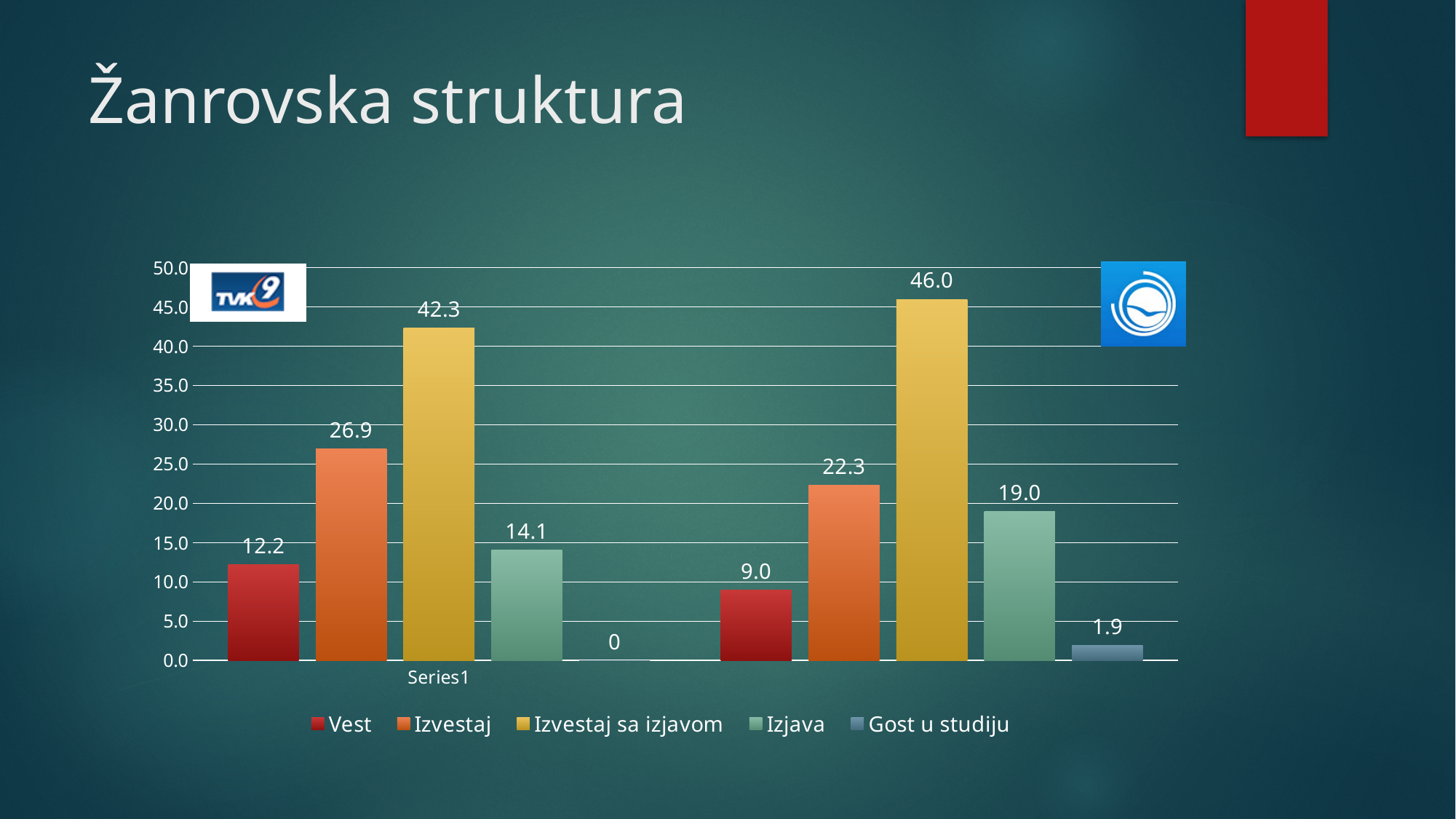
How many series does the legend list? 5 Which series has the lowest value in the left group of bars? Gost u studiju What is the value of the Gost u studiju bar in the right group of bars? 1.9 What is the value of the Izvestaj sa izjavom bar in the left group of bars? 42.3 Which series has the highest value in the right group of bars? Izvestaj sa izjavom What is the value of the Izjava bar in the left group of bars? 14.1 What type of chart is shown on the slide? bar chart What is the title of the slide containing the chart? Žanrovska struktura What is the value of the Vest bar in the right group of bars? 9.0 Which is larger: the Izvestaj value in the left group or the Izvestaj value in the right group? left group (26.9) What is the difference between the Izvestaj sa izjavom values in the right group (46.0) and the left group (42.3)? 3.7 Is the value of the Izjava bar in the right group greater or less than 15.0? greater